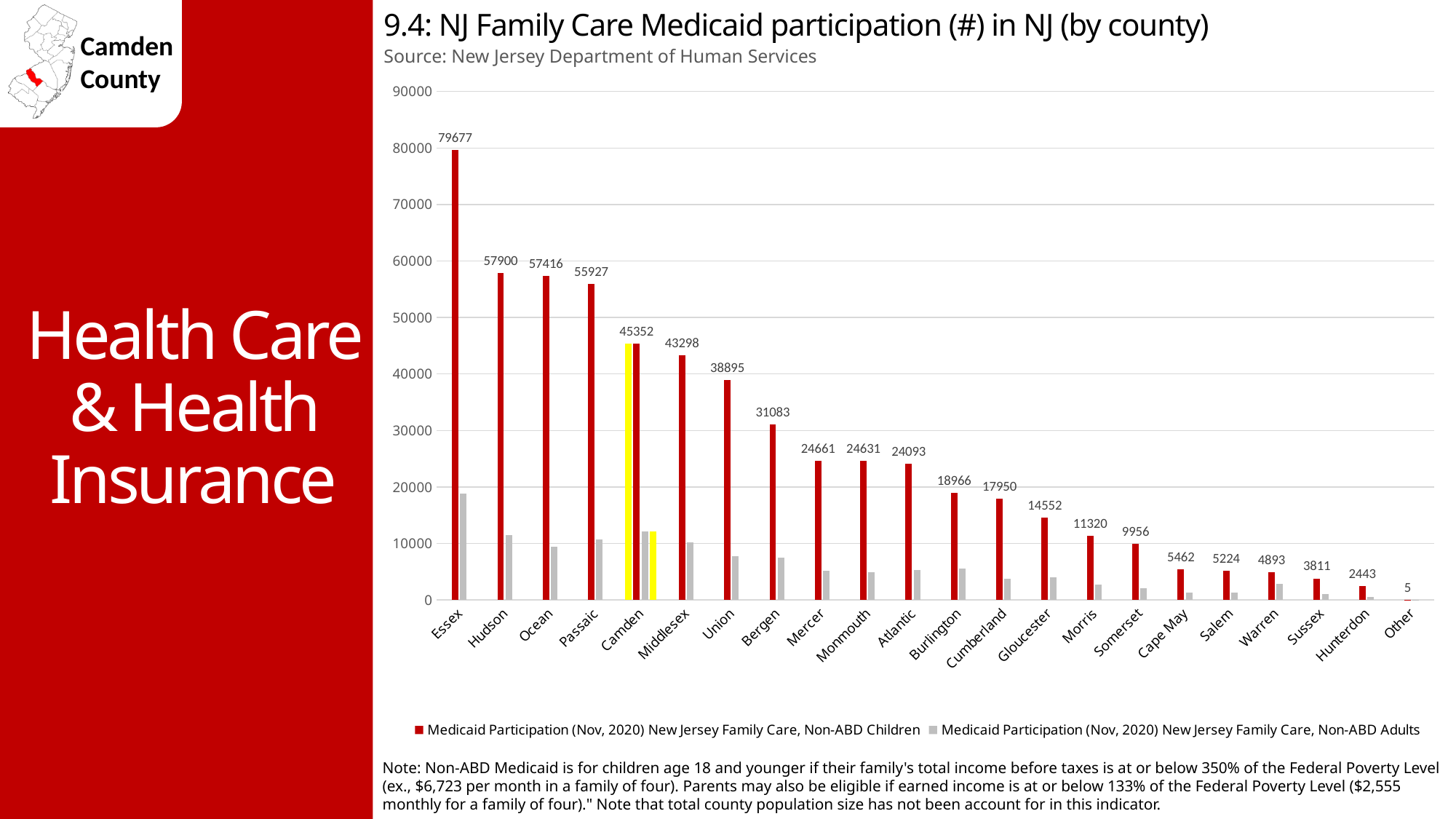
How many categories are shown on the x axis? 22 Which has a larger Non-ABD Children value, Camden or Middlesex? Camden What is the difference between the Non-ABD Children values for Hudson and Ocean? 484 What is the Non-ABD Children Medicaid participation value for Camden? 45352 Is the Non-ABD Adults value for Union greater or less than 10000? less What kind of chart is shown on the slide? Bar chart What is the Non-ABD Children Medicaid participation value for Essex? 79677 What is the Non-ABD Children Medicaid participation value for Bergen? 31083 Which county has the highest Non-ABD Children Medicaid participation? Essex Is the Non-ABD Adults value for Essex greater or less than 10000? greater How many series does the legend list? 2 Which category has the lowest Non-ABD Children Medicaid participation? Other